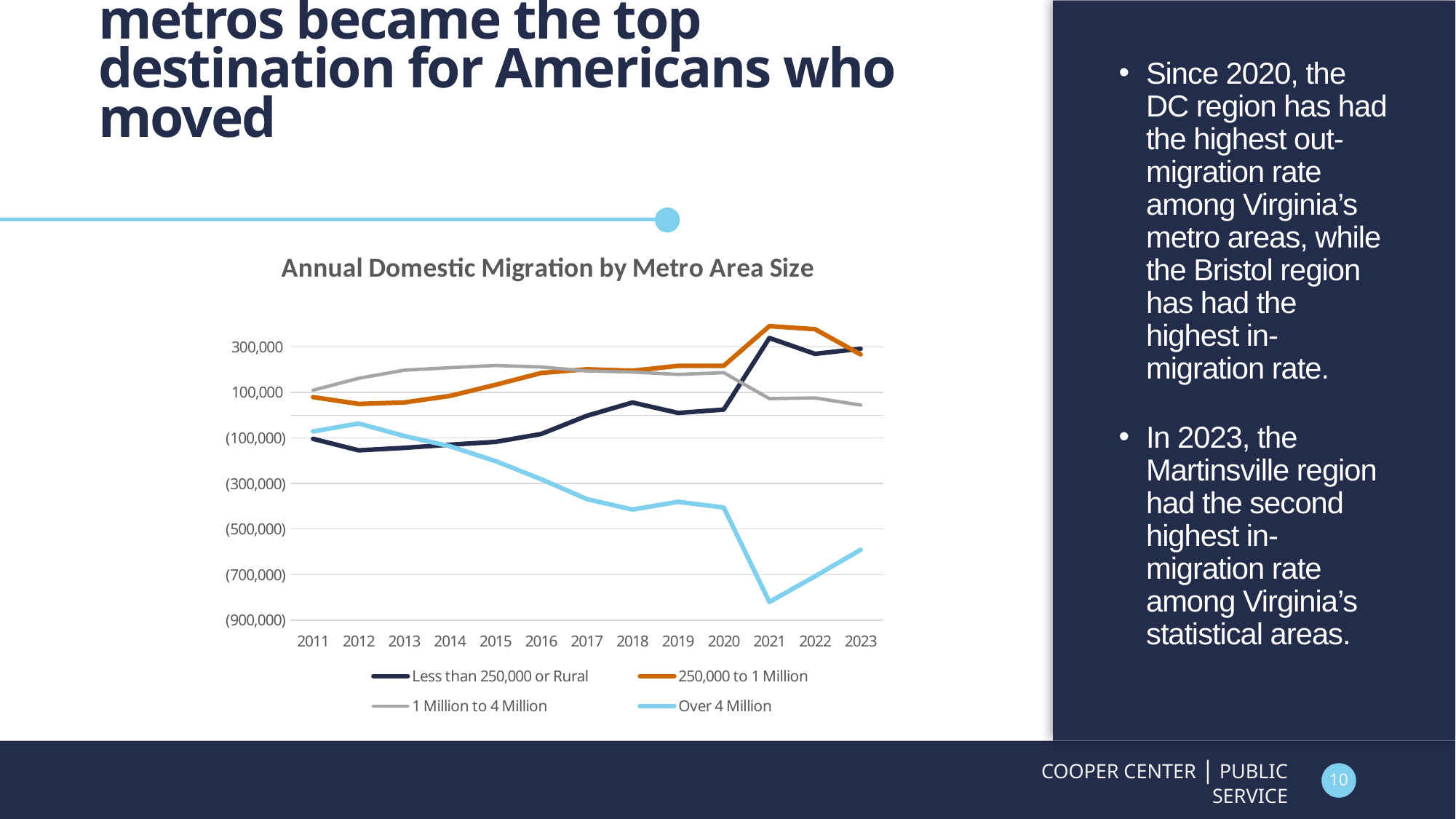
In 2023, which is larger: the value for Over 4 Million or the value for 1 Million to 4 Million? 1 Million to 4 Million Does the Over 4 Million series generally rise or fall from 2012 to 2021? fall How many years are shown on the x axis of the chart? 13 Is the value for 1 Million to 4 Million in 2015 greater or less than 100,000? greater What is the title of the chart? Annual Domestic Migration by Metro Area Size How many series does the chart's legend list? 4 Is the value for 250,000 to 1 Million in 2021 greater or less than 300,000? greater What kind of chart is shown on the slide? line chart Is the value for Less than 250,000 or Rural in 2012 greater or less than (100,000)? less Which series has the lowest value in 2021? Over 4 Million Which series has the highest value in 2021? 250,000 to 1 Million